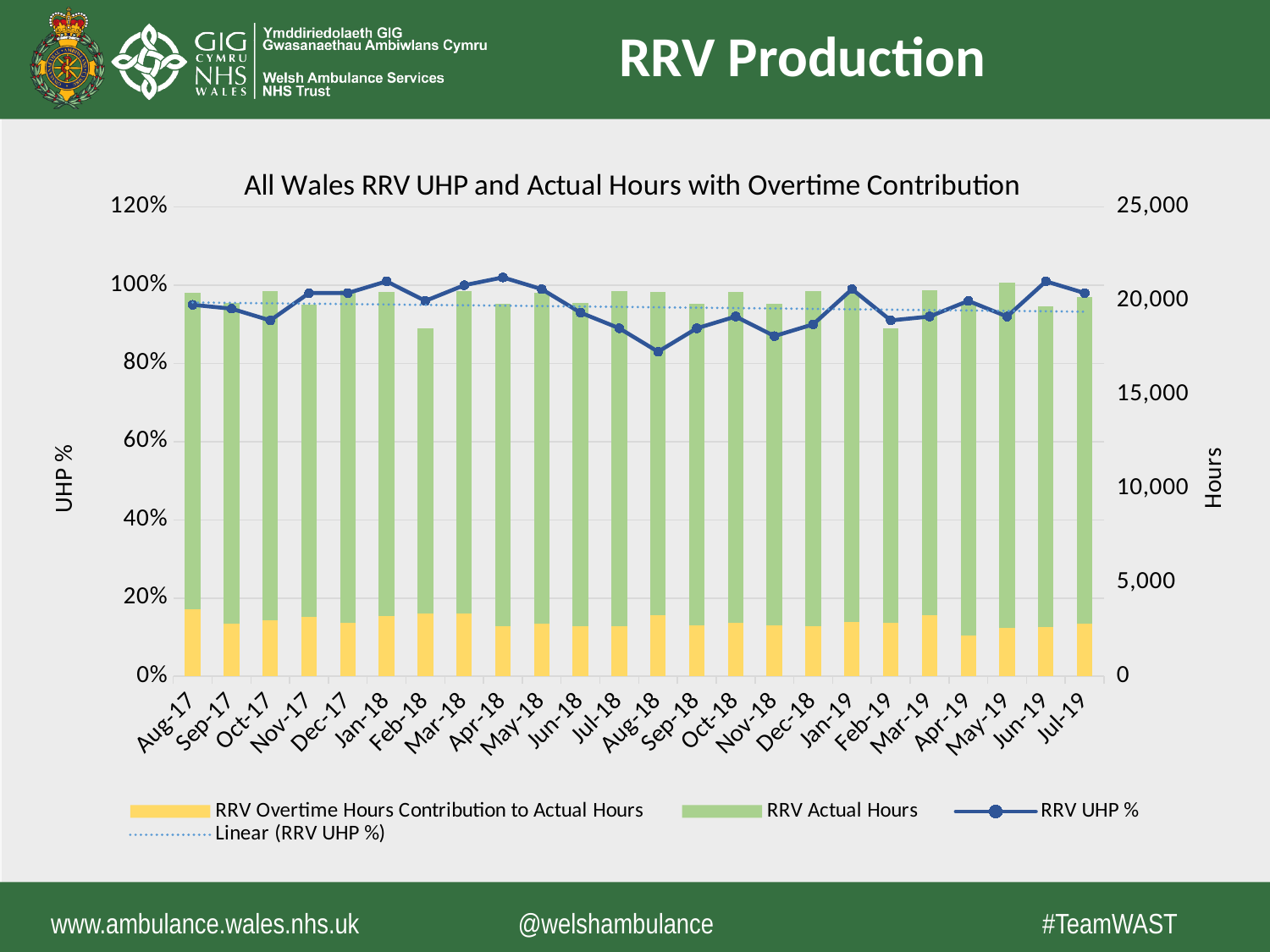
How many entries does the chart legend list? 4 Which month has the tallest stacked bar (highest total hours)? May-19 In which month does the RRV UHP % line reach its lowest point? Aug-18 Does the dotted linear trend line for RRV UHP % rise or fall from Aug-17 to Jul-19? fall Is the RRV UHP % value for Aug-18 greater or less than 90%? less How many months are shown along the x axis of the chart? 24 Is the RRV Overtime Hours Contribution for Aug-17 greater or less than 2,500 hours? greater What is the title of the chart? All Wales RRV UHP and Actual Hours with Overtime Contribution What kind of chart is shown on the slide? Combined stacked bar and line chart In which month does the RRV UHP % line reach its highest point? Apr-18 Is the RRV UHP % value for Apr-18 greater or less than 100%? greater